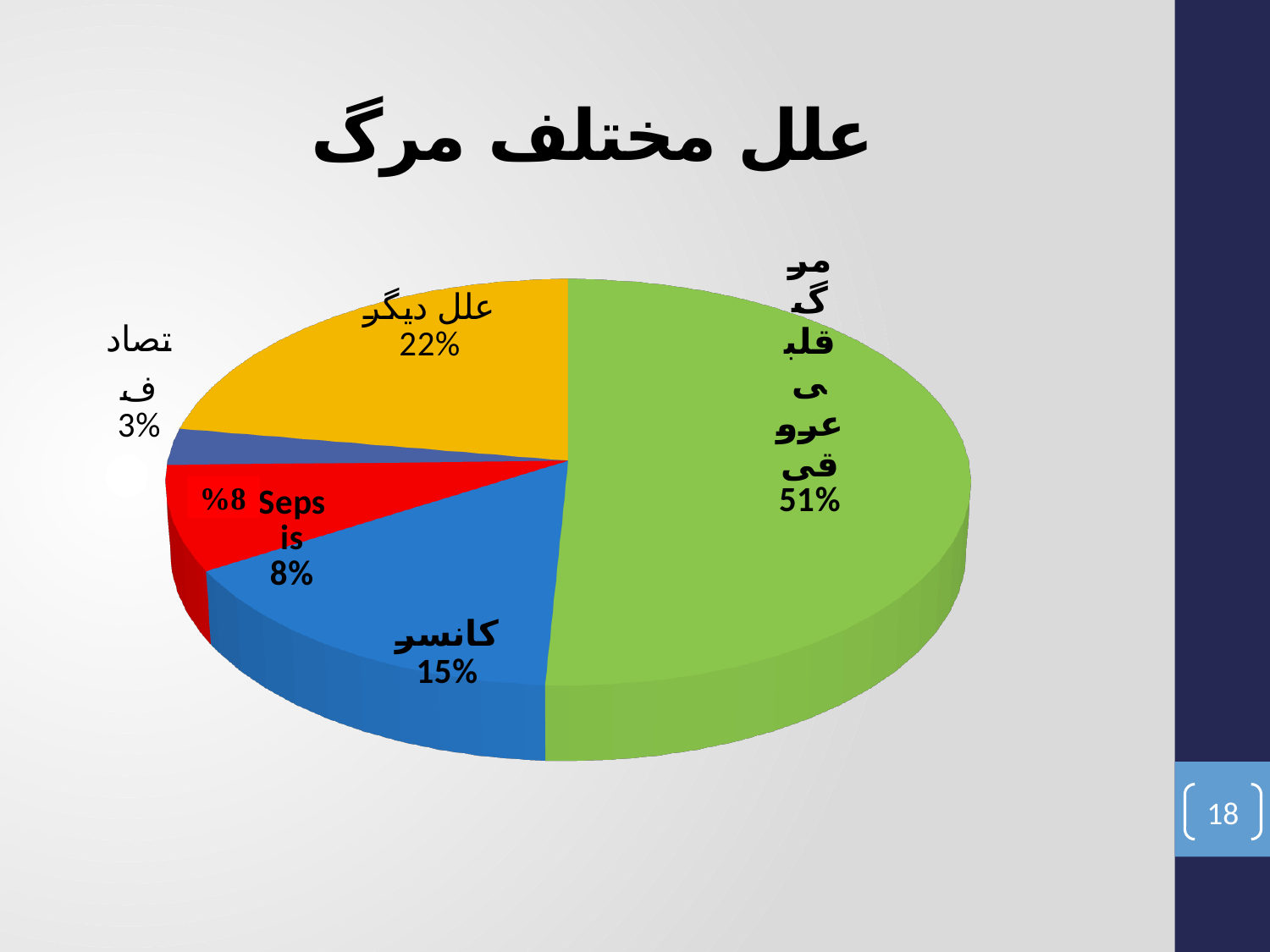
What percentage of the pie is labelled علل دیگر? 22% What percentage of the pie is labelled کانسر? 15% What is the title of the chart? علل مختلف مرگ What percentage of the pie is labelled تصادف? 3% How many slices does the pie chart have? 5 Which slice of the pie is the smallest? تصادف What kind of chart is shown on the slide? pie chart What is the difference in percentage points between علل دیگر and کانسر? 7 What percentage of the pie is labelled مرگ قلبی عروقی? 51% What percentage of the pie is labelled Sepsis? 8% Which is larger, the slice for کانسر or the slice for Sepsis? کانسر Which slice of the pie is the largest? مرگ قلبی عروقی